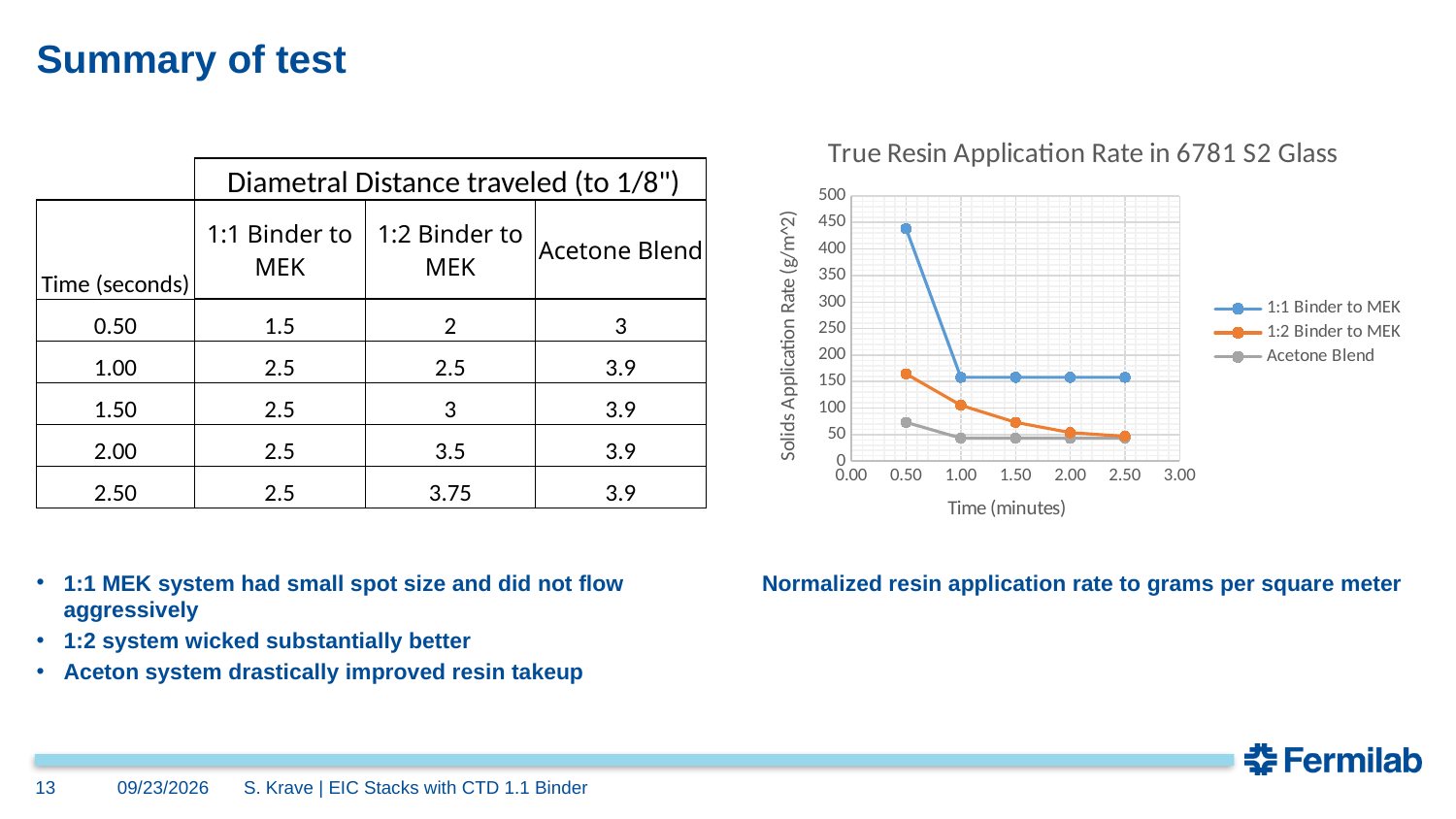
Is the value for 1:1 Binder to MEK at 2.50 minutes greater or less than 100? greater What is the x-axis title of the chart? Time (minutes) Is the value for 1:2 Binder to MEK at 1.00 minutes greater or less than 150? less Is the value for 1:1 Binder to MEK at 0.50 minutes greater or less than 400? greater Which series has the highest value at 0.50 minutes in the chart? 1:1 Binder to MEK Which series has the lowest value at 0.50 minutes in the chart? Acetone Blend At 1.50 minutes, which is larger: 1:1 Binder to MEK or 1:2 Binder to MEK? 1:1 Binder to MEK Does the 1:1 Binder to MEK series rise or fall between 0.50 and 1.00 minutes? fall How many series does the legend of the 'True Resin Application Rate in 6781 S2 Glass' chart list? 3 What kind of chart is 'True Resin Application Rate in 6781 S2 Glass'? line chart How many data points are plotted for the 1:1 Binder to MEK series in the chart? 5